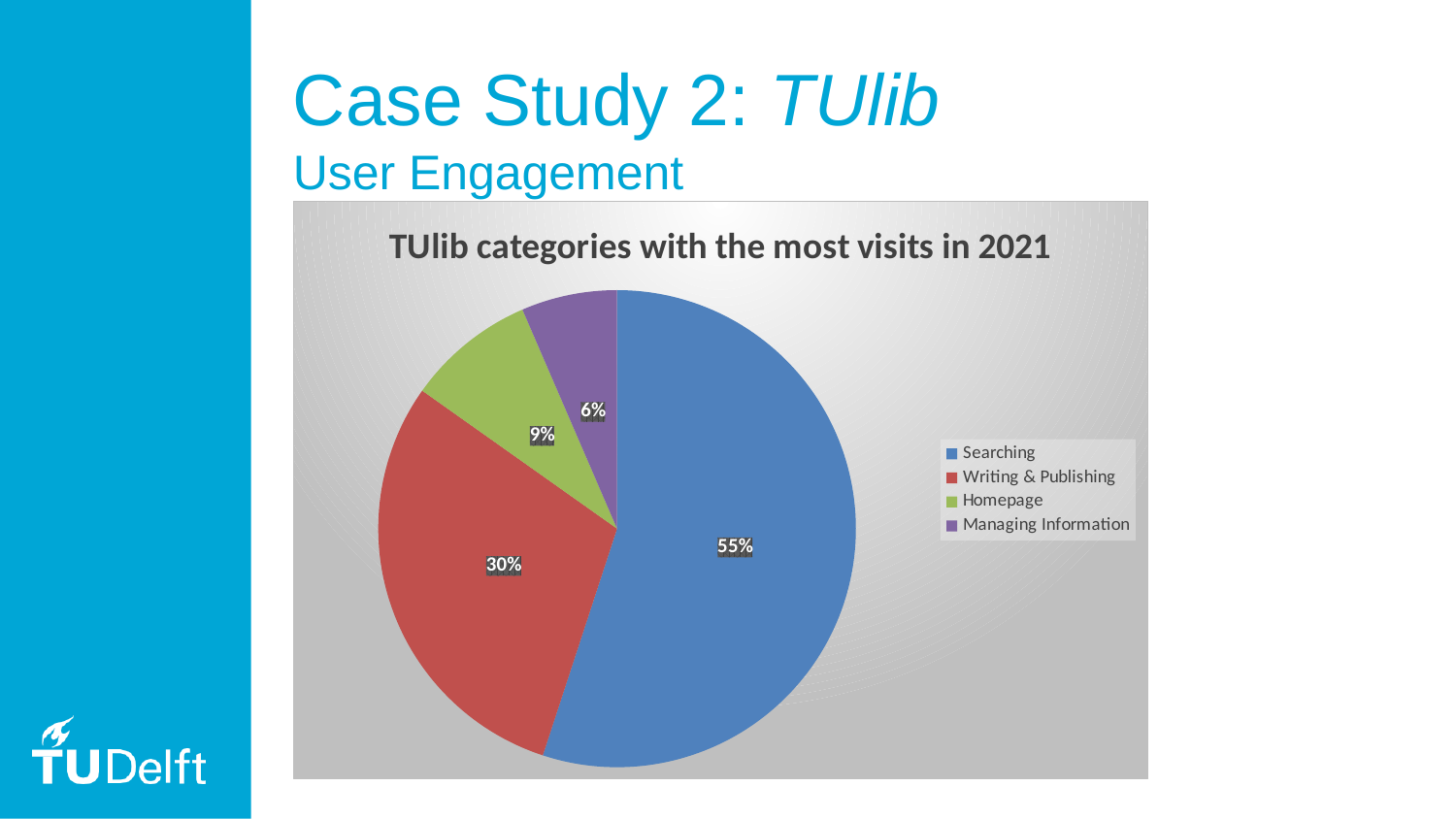
How many categories are shown in the pie chart? 4 Which has a larger share, Homepage or Managing Information? Homepage Which colour represents Writing & Publishing in the chart? red What share of visits does the Managing Information slice represent? 6% What share of visits does the Searching slice represent? 55% What kind of chart is shown on the slide? pie chart Which category has the largest share of visits? Searching What share of visits does the Homepage slice represent? 9% What is the title of the chart? TUlib categories with the most visits in 2021 Which category has the smallest share of visits? Managing Information What is the difference in percentage points between Searching and Writing & Publishing? 25